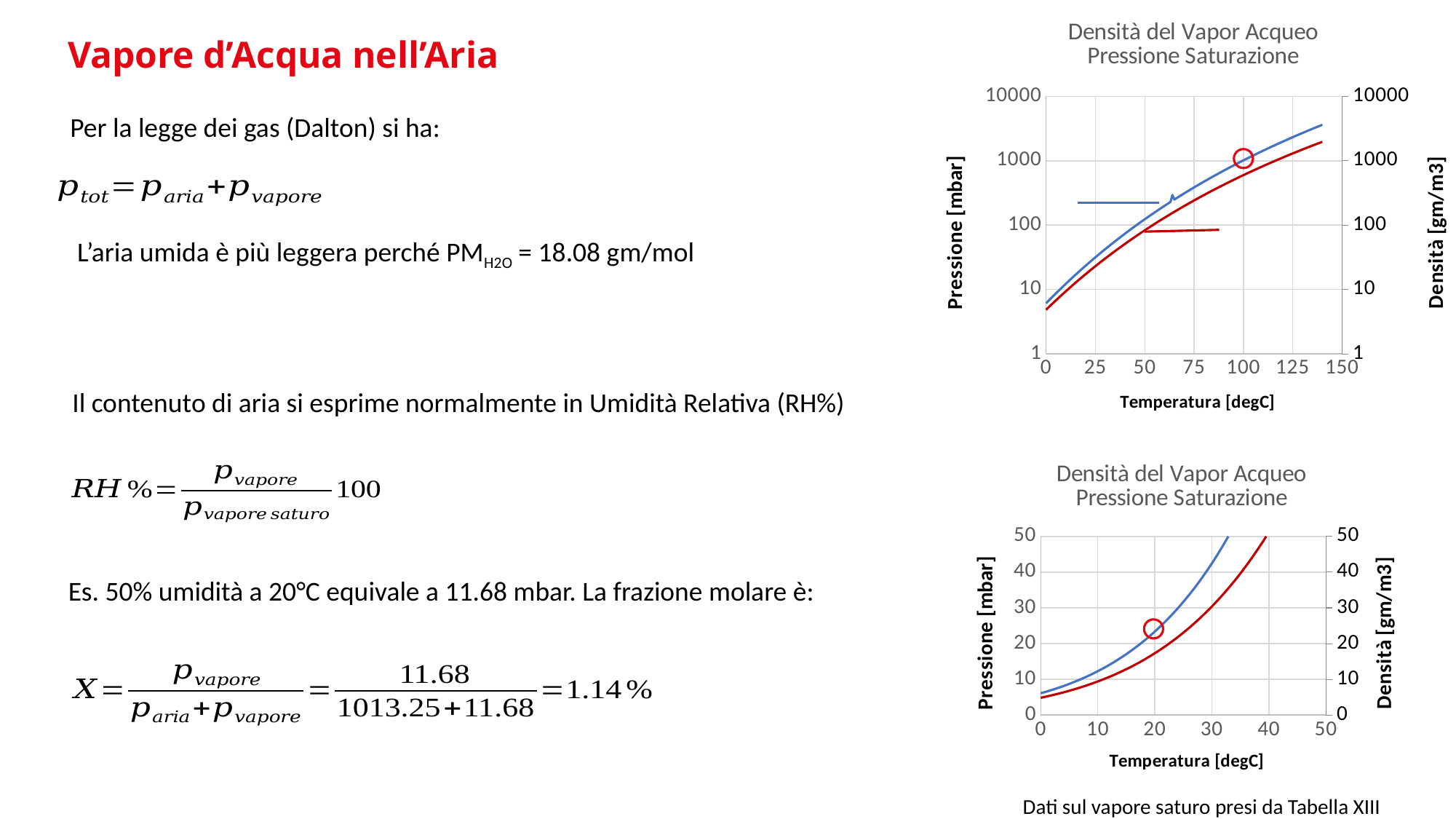
In the bottom chart, at 20 degC, which line has the higher value, the blue line or the red line? the blue line In the top chart, is the value of the red line at 0 degC greater or less than 10? less What kind of chart is the bottom chart on the slide? line chart In the bottom chart, is the value of the blue line at 20 degC greater or less than 20? greater What is the label of the x axis of the top chart? Temperatura [degC] What kind of chart is the top chart on the slide? line chart In the top chart, is the value of the blue line at 25 degC greater or less than 100? less In the bottom chart, do the plotted values rise or fall as temperature increases? rise How many lines are plotted in the bottom chart? 2 In the top chart, do the plotted values rise or fall as temperature increases? rise